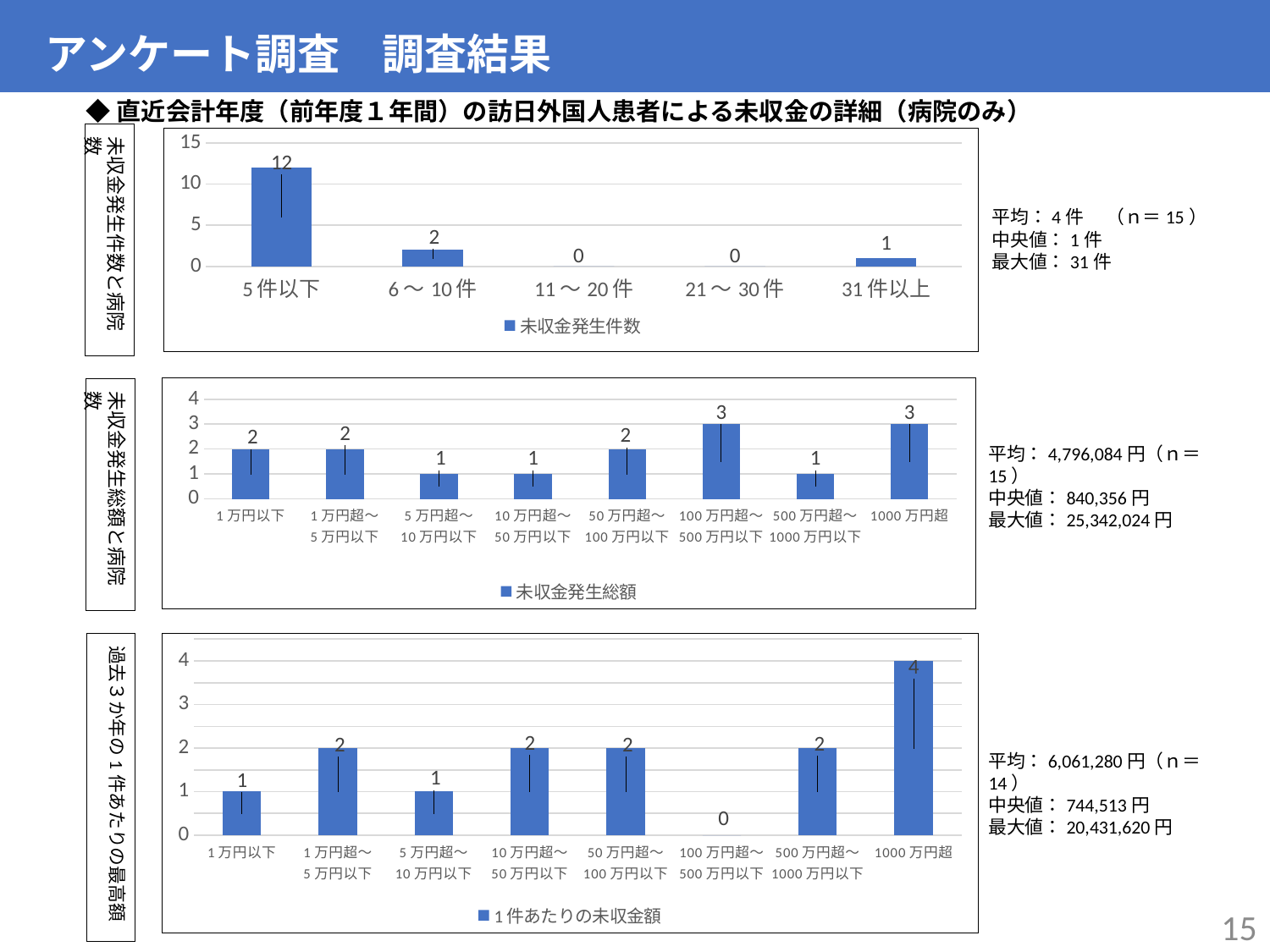
In the bottom chart (1件あたりの未収金額), what is the difference between the values for 1000万円超 and 1万円以下? 3 In the top chart (未収金発生件数), what is the value for 5件以下? 12 In the middle chart (未収金発生総額), what is the value for 1000万円超? 3 How many categories are shown on the x axis of the top chart (未収金発生件数)? 5 How many series does the legend of the top chart list? 1 In the middle chart (未収金発生総額), which is larger, the value for 100万円超～500万円以下 or the value for 500万円超～1000万円以下? 100万円超～500万円以下 In the bottom chart (1件あたりの未収金額), which category has the lowest value? 100万円超～500万円以下 In the bottom chart (1件あたりの未収金額), what is the value for 1000万円超? 4 In the top chart (未収金発生件数), what is the difference between the values for 5件以下 and 6～10件? 10 In the top chart (未収金発生件数), which category has the highest value? 5件以下 How many categories are shown on the x axis of the middle chart (未収金発生総額)? 8 What type of chart is the bottom chart (1件あたりの未収金額)? Bar chart